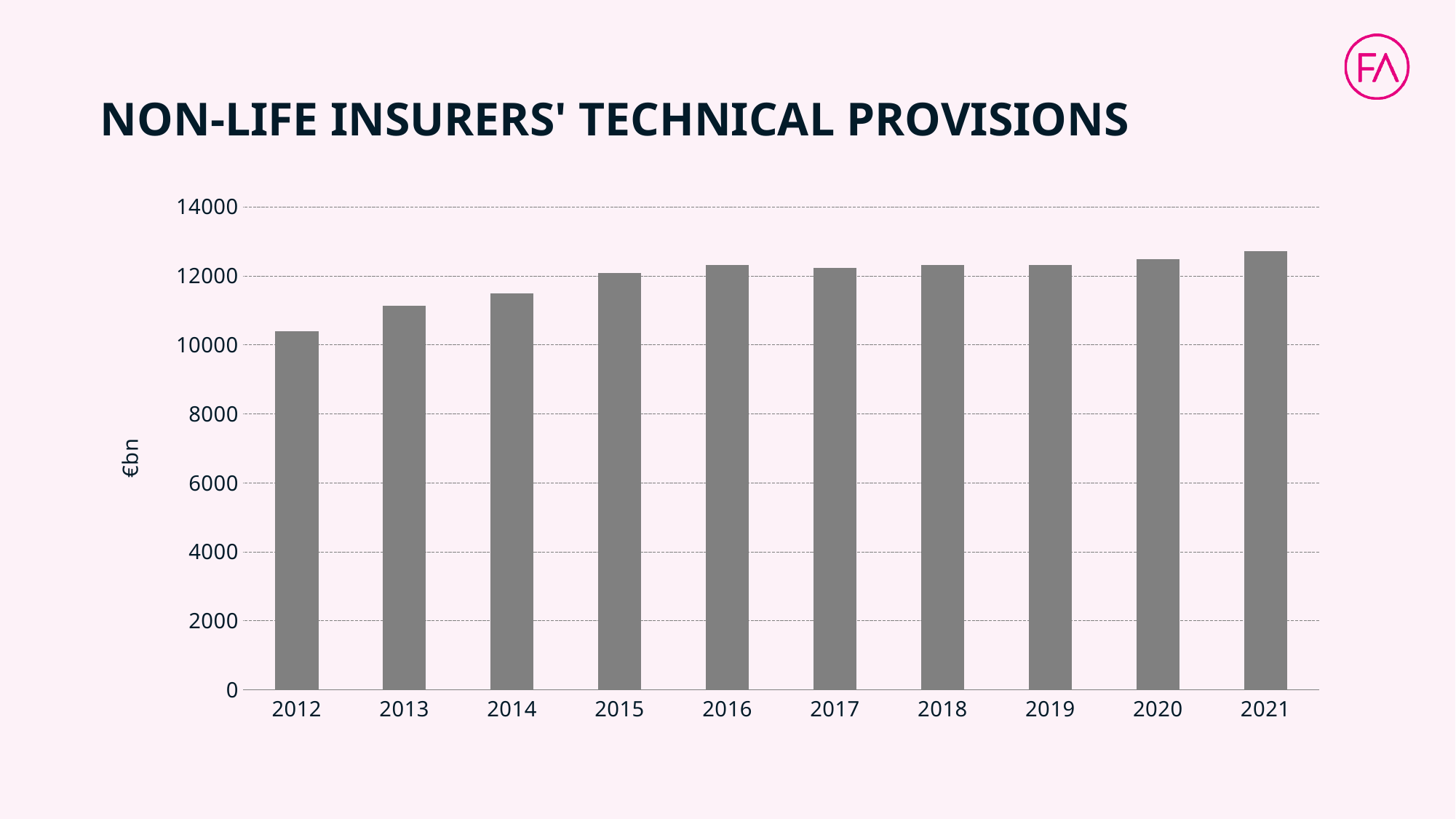
Is the value for 2021 greater or less than 12000? greater What kind of chart is shown on the slide? bar chart Which year has the lowest value for non-life insurers' technical provisions? 2012 Which year has the larger value, 2012 or 2021? 2021 Is the value for 2012 greater or less than 12000? less Is the value for 2012 greater or less than 10000? greater What unit is shown on the y axis label of the chart? €bn How many years are shown on the x axis of the chart? 10 Do the values generally rise or fall from 2012 to 2021? rise Which year has the highest value for non-life insurers' technical provisions? 2021